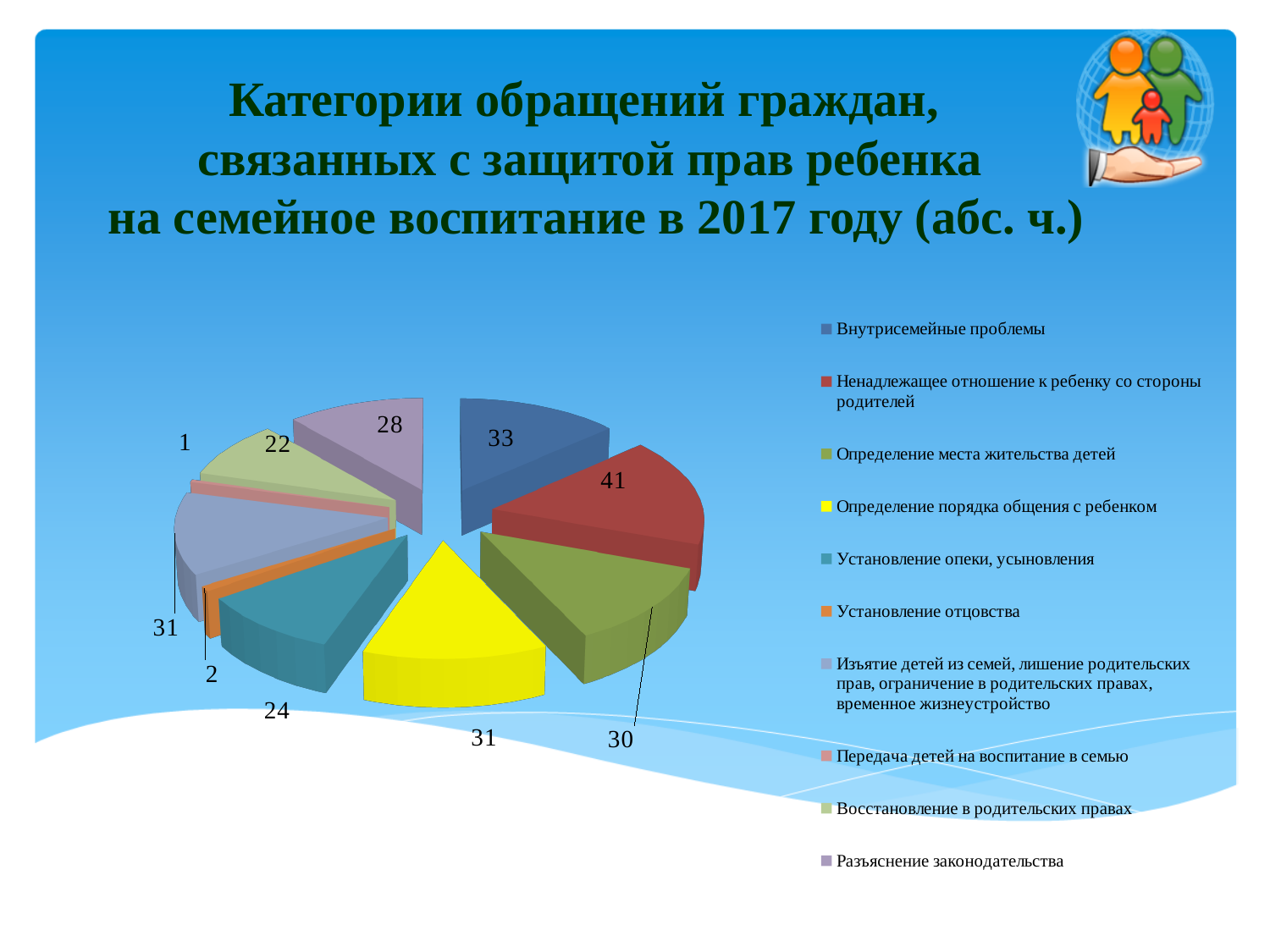
What is the value for "Установление отцовства"? 2 What is the value for "Ненадлежащее отношение к ребенку со стороны родителей"? 41 How many categories does the pie chart show? 10 Which category has the highest value in the pie chart? Ненадлежащее отношение к ребенку со стороны родителей What is the difference between the values for "Ненадлежащее отношение к ребенку со стороны родителей" and "Внутрисемейные проблемы"? 8 Which category has the lowest value in the pie chart? Передача детей на воспитание в семью What is the value for "Внутрисемейные проблемы"? 33 Which is larger: the value for "Определение места жительства детей" or the value for "Восстановление в родительских правах"? Определение места жительства детей What is the value for "Разъяснение законодательства"? 28 What is the value for "Установление опеки, усыновления"? 24 What type of chart is shown on the slide? Pie chart Which colour represents "Определение порядка общения с ребенком" in the pie chart? Yellow